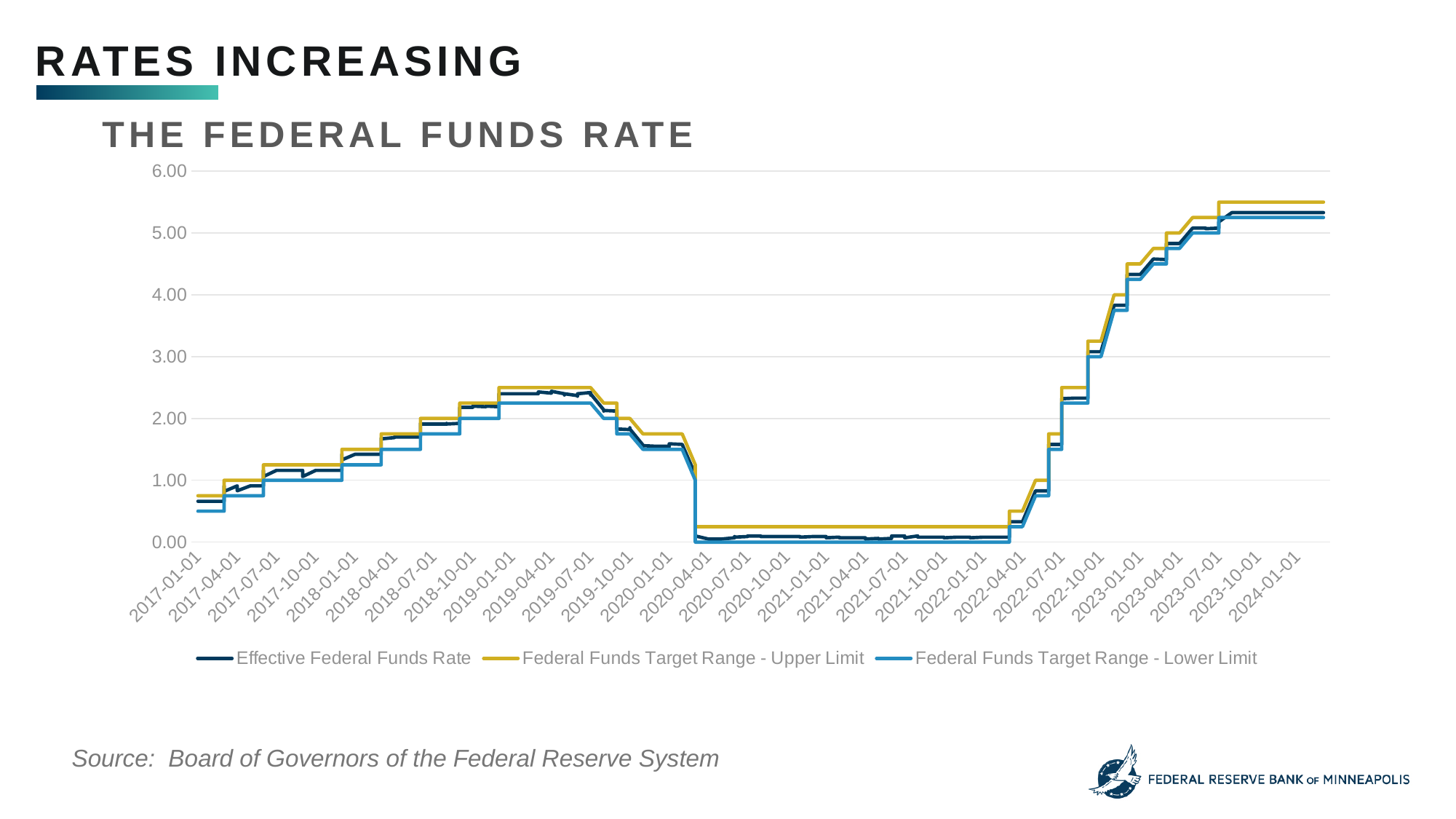
Is the value of the Federal Funds Target Range - Lower Limit at 2021-01-01 greater or less than 1.00? less Is the Effective Federal Funds Rate at 2020-07-01 greater or less than 1.00? less Is the Effective Federal Funds Rate higher at 2019-04-01 or at 2021-04-01? 2019-04-01 Is the value of the Federal Funds Target Range - Upper Limit at 2019-04-01 greater or less than 2.00? greater Do the rates rise or fall between 2022-04-01 and 2023-07-01? Rise Which is larger at 2023-10-01: the Federal Funds Target Range - Upper Limit or the Federal Funds Target Range - Lower Limit? Federal Funds Target Range - Upper Limit Which series is drawn in yellow according to the legend? Federal Funds Target Range - Upper Limit What is the title of the chart? THE FEDERAL FUNDS RATE Do the rates rise or fall between 2019-07-01 and 2020-04-01? Fall How many series does the legend list? 3 What kind of chart is shown on the slide? Line chart